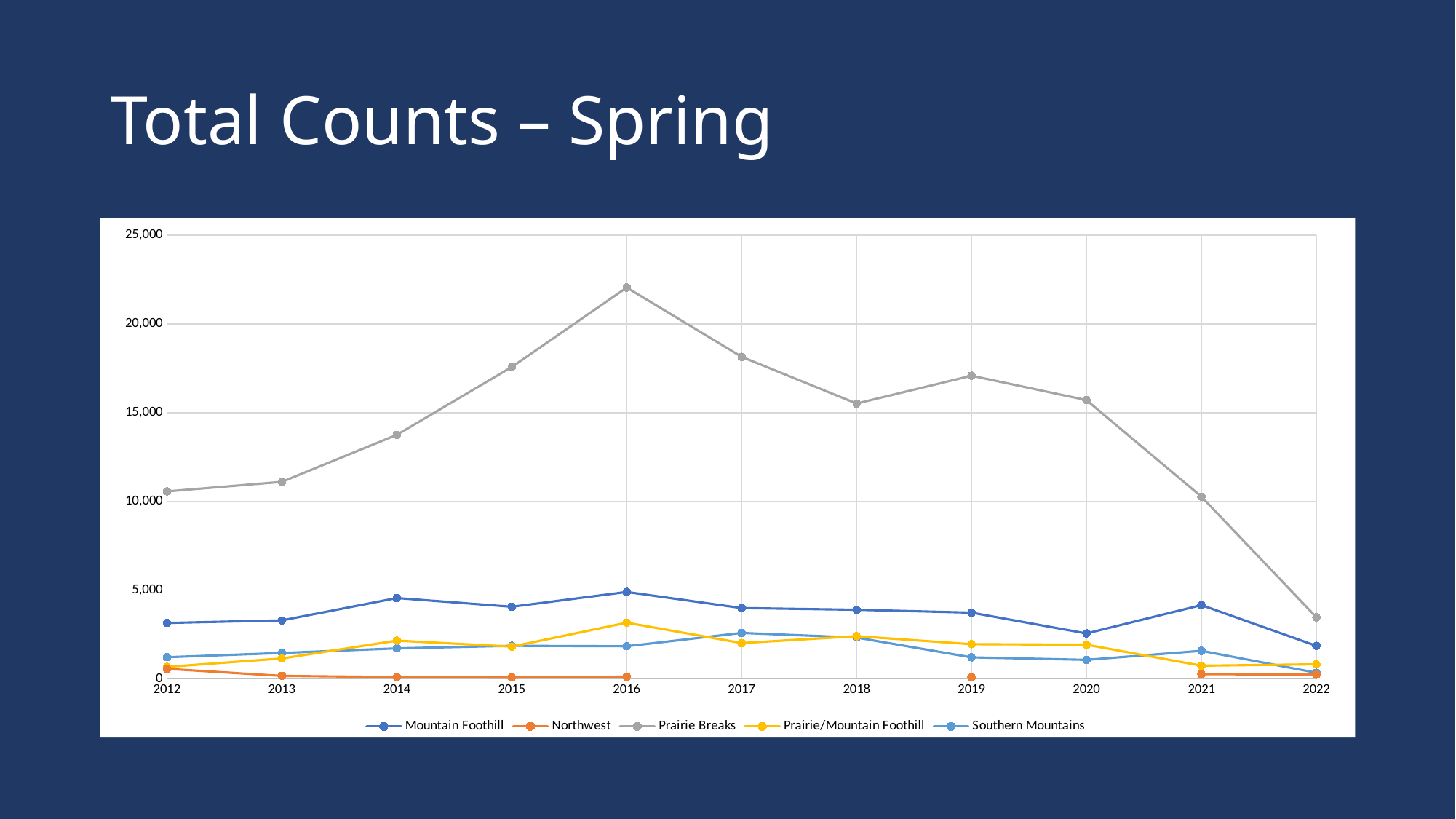
Does the Prairie Breaks series rise or fall from 2019 to 2022? fall How many years are shown along the x axis? 11 How many series does the legend list? 5 What kind of chart is shown on the slide? line chart Is the value for Prairie Breaks in 2015 greater or less than 15,000? greater Is the value for Prairie Breaks in 2016 greater or less than 20,000? greater In which year does the Prairie Breaks series reach its highest value? 2016 Which is larger for Prairie Breaks: the value in 2017 or the value in 2018? 2017 What is the title of the slide? Total Counts – Spring Which series has the lowest values across the chart? Northwest Which series has the highest value in 2016? Prairie Breaks Is the value for Prairie Breaks in 2022 greater or less than 5,000? less